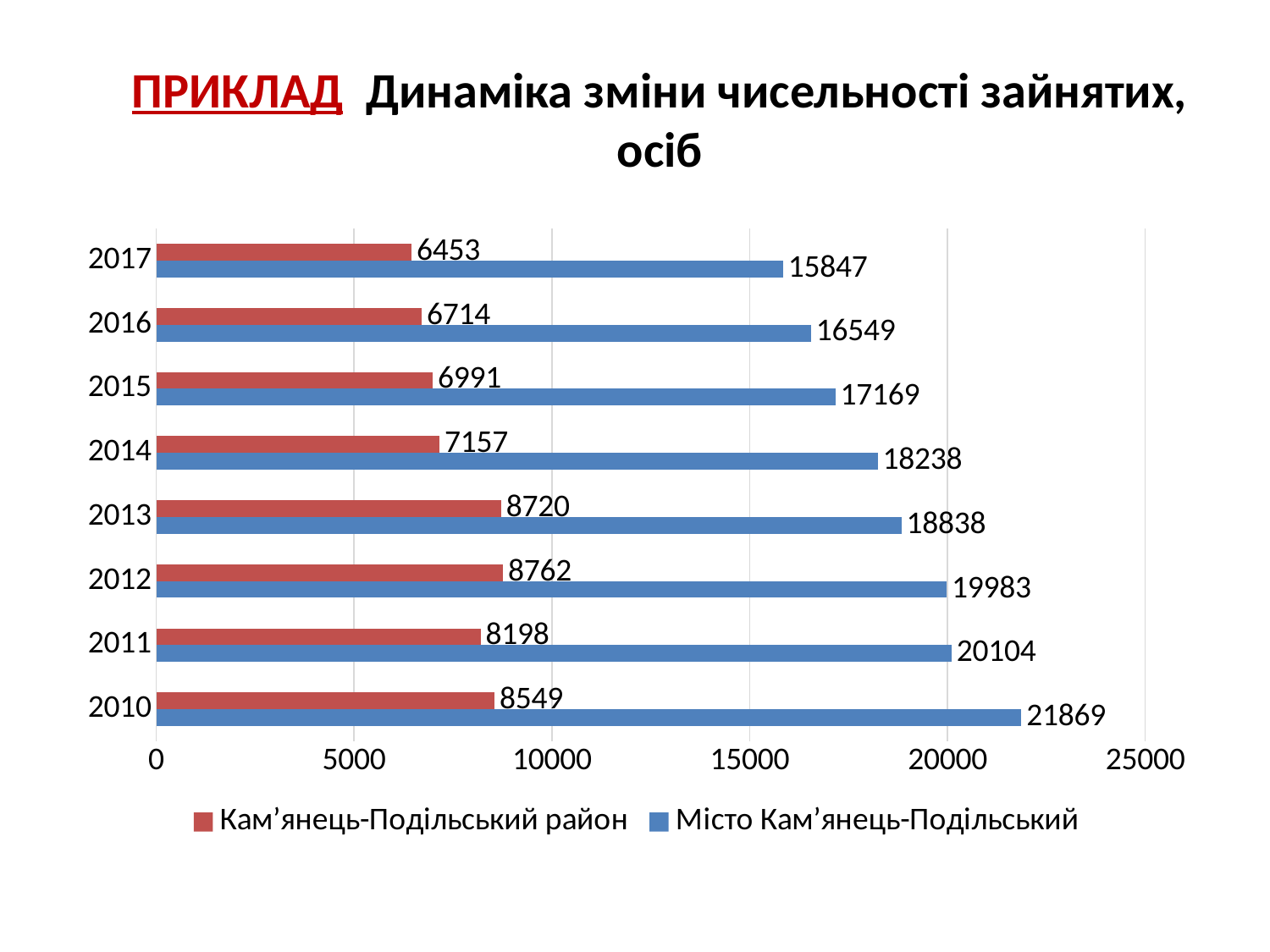
What is the value for Місто Кам’янець-Подільський in 2017? 15847 Do the values for Місто Кам’янець-Подільський rise or fall from 2010 to 2017? fall Which year has the larger value for Кам’янець-Подільський район, 2011 or 2012? 2012 What kind of chart is shown on the slide? bar chart In which year is the value for Місто Кам’янець-Подільський the highest? 2010 What is the value for Кам’янець-Подільський район in 2013? 8720 Is the value for Місто Кам’янець-Подільський in 2016 greater or less than 20000? less How many series does the legend list? 2 In which year is the value for Кам’янець-Подільський район the lowest? 2017 What is the difference between the values for Місто Кам’янець-Подільський and Кам’янець-Подільський район in 2010? 13320 How many years are shown on the chart? 8 By how much did the value for Місто Кам’янець-Подільський decrease from 2014 to 2015? 1069